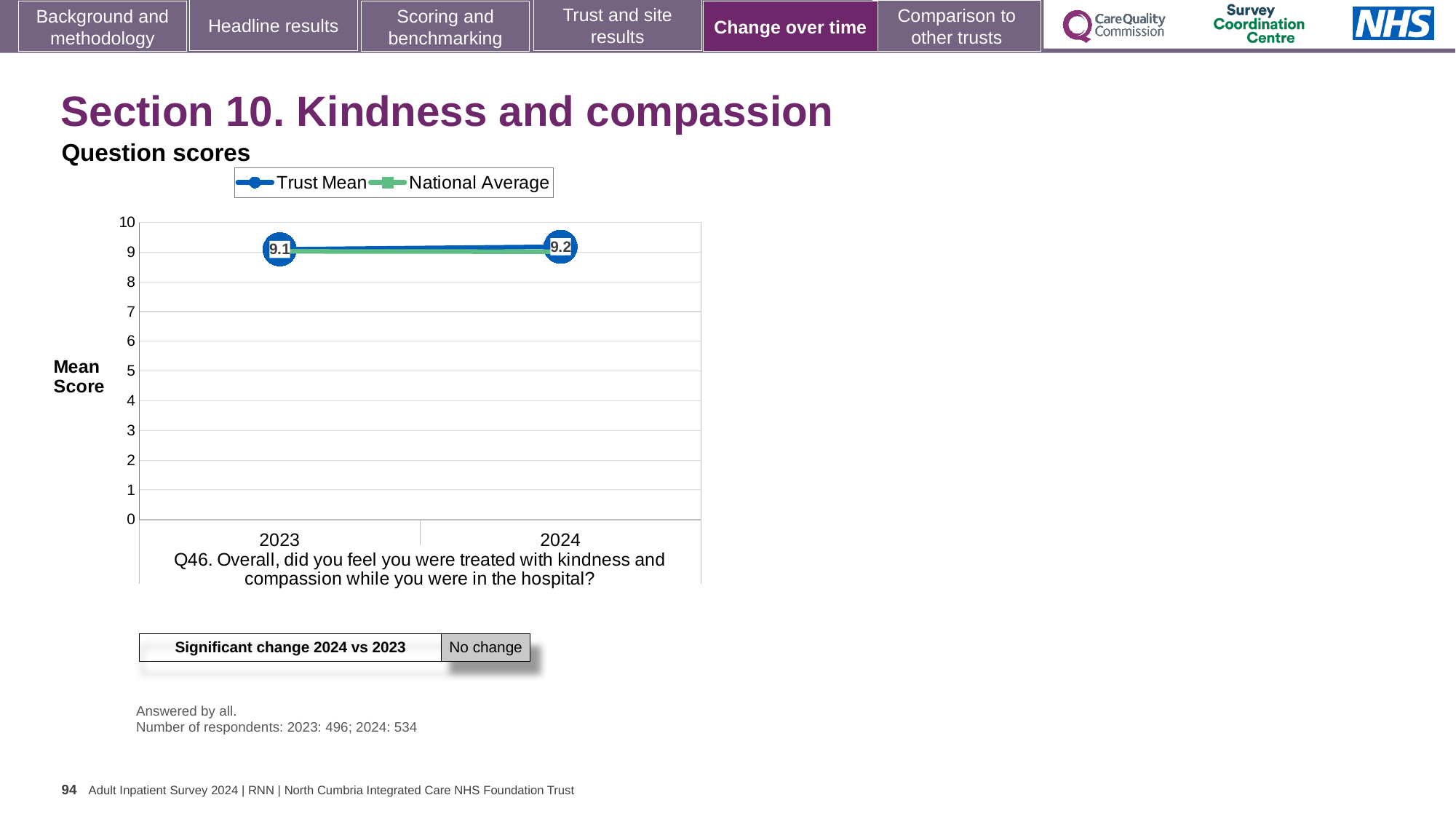
What is the label of the y axis on the chart? Mean Score How many years are plotted on the x axis of the chart? 2 What is the Trust Mean score for 2023 on the Q46 chart? 9.1 Is the National Average score for 2024 greater or less than 8? greater Is the Trust Mean score for 2023 greater or less than 5? greater In which year is the Trust Mean score higher, 2023 or 2024? 2024 How many series does the chart legend list? 2 What is the Trust Mean score for 2024 on the Q46 chart? 9.2 Does the Trust Mean score rise or fall from 2023 to 2024? Rise What kind of chart is shown on the slide? Line chart Which series is shown in green in the chart legend? National Average What is the difference between the Trust Mean scores for 2024 and 2023? 0.1